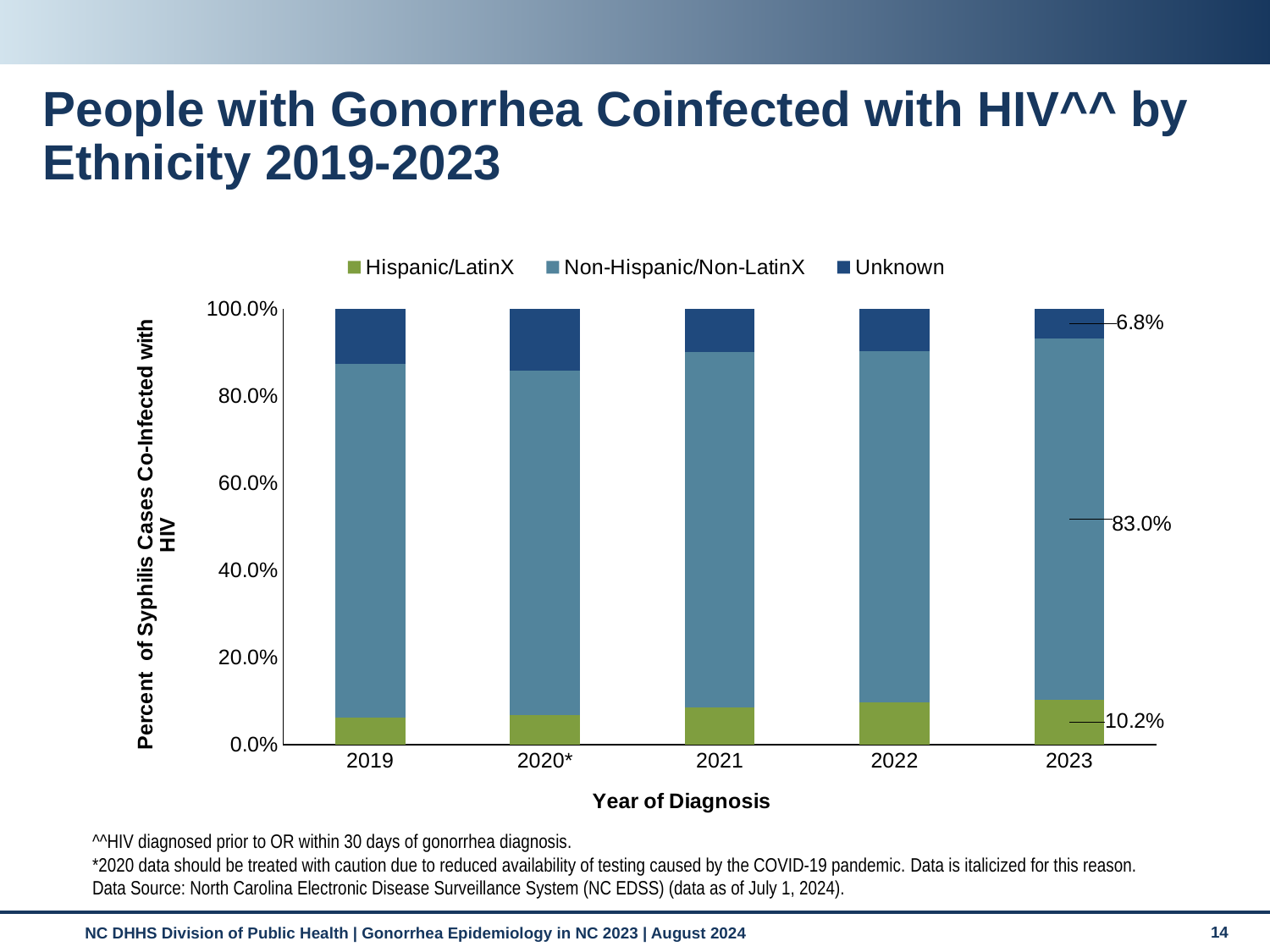
Is the Hispanic/LatinX value for 2019 greater or less than 20%? less What is the total of the three segments in the 2023 bar? 100.0% In 2023, which is larger: the Hispanic/LatinX value or the Unknown value? Hispanic/LatinX What kind of chart is shown on the slide? Stacked bar chart What percentage of the 2023 bar is Hispanic/LatinX? 10.2% What is the Unknown value for 2023? 6.8% What is the Non-Hispanic/Non-LatinX value for 2023? 83.0% What is the title of the x axis? Year of Diagnosis How many series does the legend list? 3 Does the Hispanic/LatinX share rise or fall from 2019 to 2023? Rise In 2023, what is the difference between the Non-Hispanic/Non-LatinX and Hispanic/LatinX values? 72.8% How many years are shown on the x axis? 5